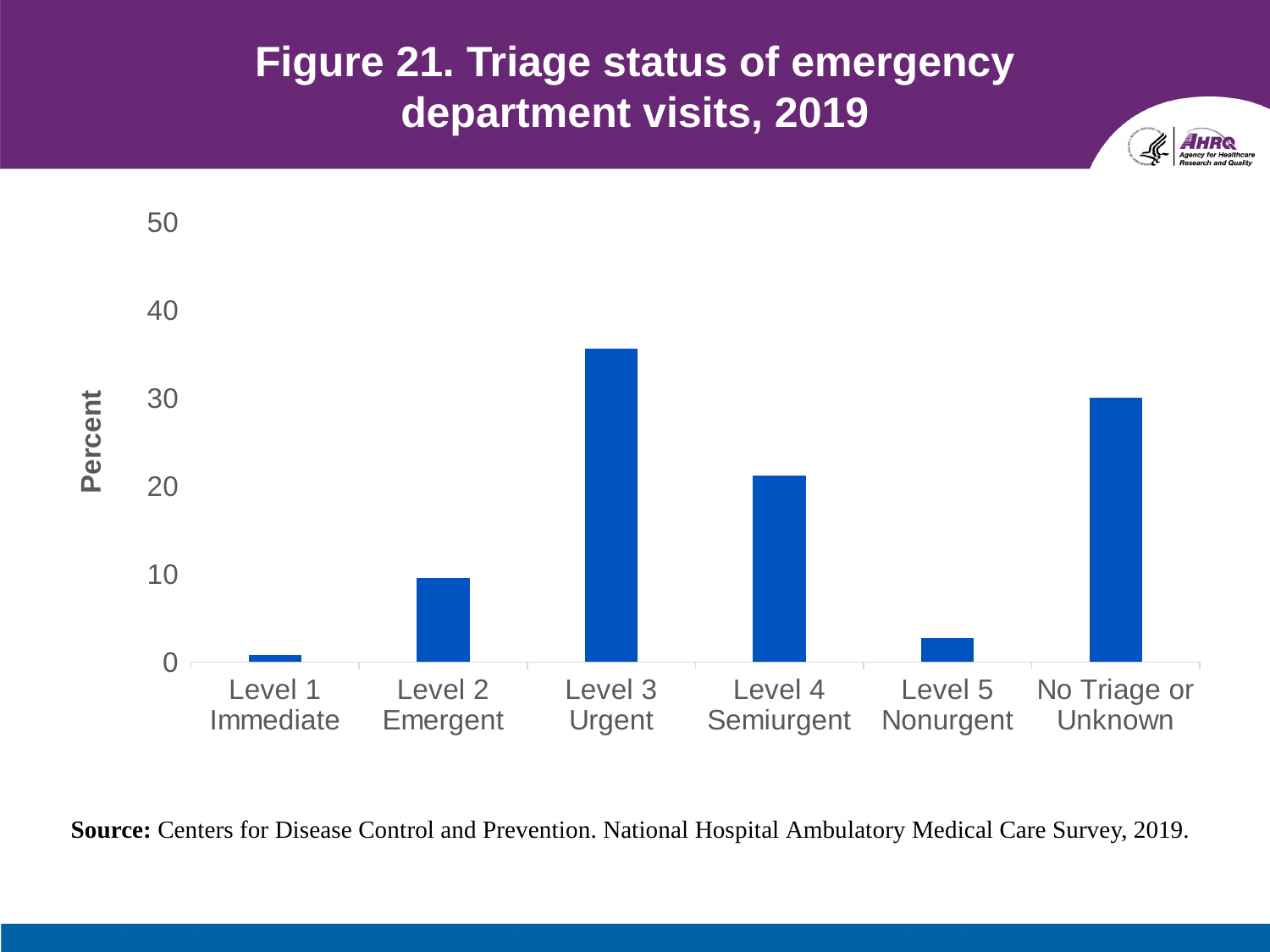
Is the value for Level 3 Urgent greater or less than 30? greater Is the value for Level 5 Nonurgent greater or less than 10? less How many triage status categories are shown on the x axis? 6 Which triage status category has the highest percentage of emergency department visits? Level 3 Urgent What is the label on the vertical axis of the chart? Percent Which is larger, the value for Level 2 Emergent or the value for Level 5 Nonurgent? Level 2 Emergent Which triage status category has the lowest percentage of emergency department visits? Level 1 Immediate Is the value for Level 4 Semiurgent greater or less than 20? greater Which is larger, the value for Level 4 Semiurgent or the value for No Triage or Unknown? No Triage or Unknown What kind of chart is shown on the slide? bar chart